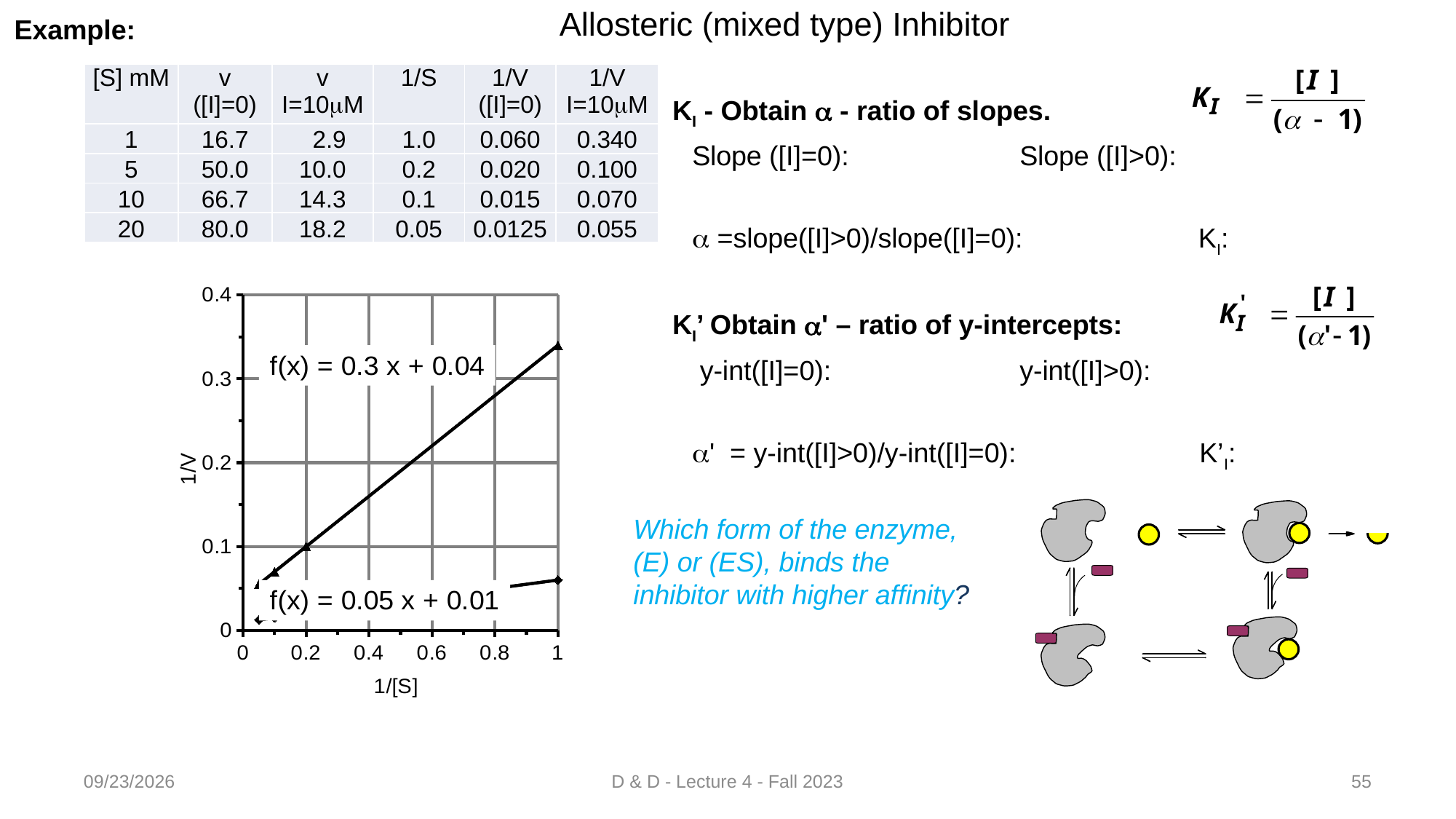
What is the y-intercept of the fitted line f(x) = 0.05 x + 0.01? 0.01 What is the label of the y axis of the chart? 1/V How many data points are plotted for each series on the chart? 4 What is the slope of the fitted line f(x) = 0.3 x + 0.04? 0.3 What is the equation of the steeper fitted line shown on the chart? f(x) = 0.3 x + 0.04 What is the label of the x axis of the chart? 1/[S] What kind of chart is shown on the slide? Line chart (scatter plot with fitted lines) At 1/[S] = 1, is the 1/V value of the steeper line greater or less than 0.3? greater At 1/[S] = 1, is the 1/V value of the shallower line greater or less than 0.1? less Do the 1/V values rise or fall as 1/[S] increases along the x axis? Rise What is the equation of the shallower fitted line shown on the chart? f(x) = 0.05 x + 0.01 How many data series (lines) are plotted on the chart? 2